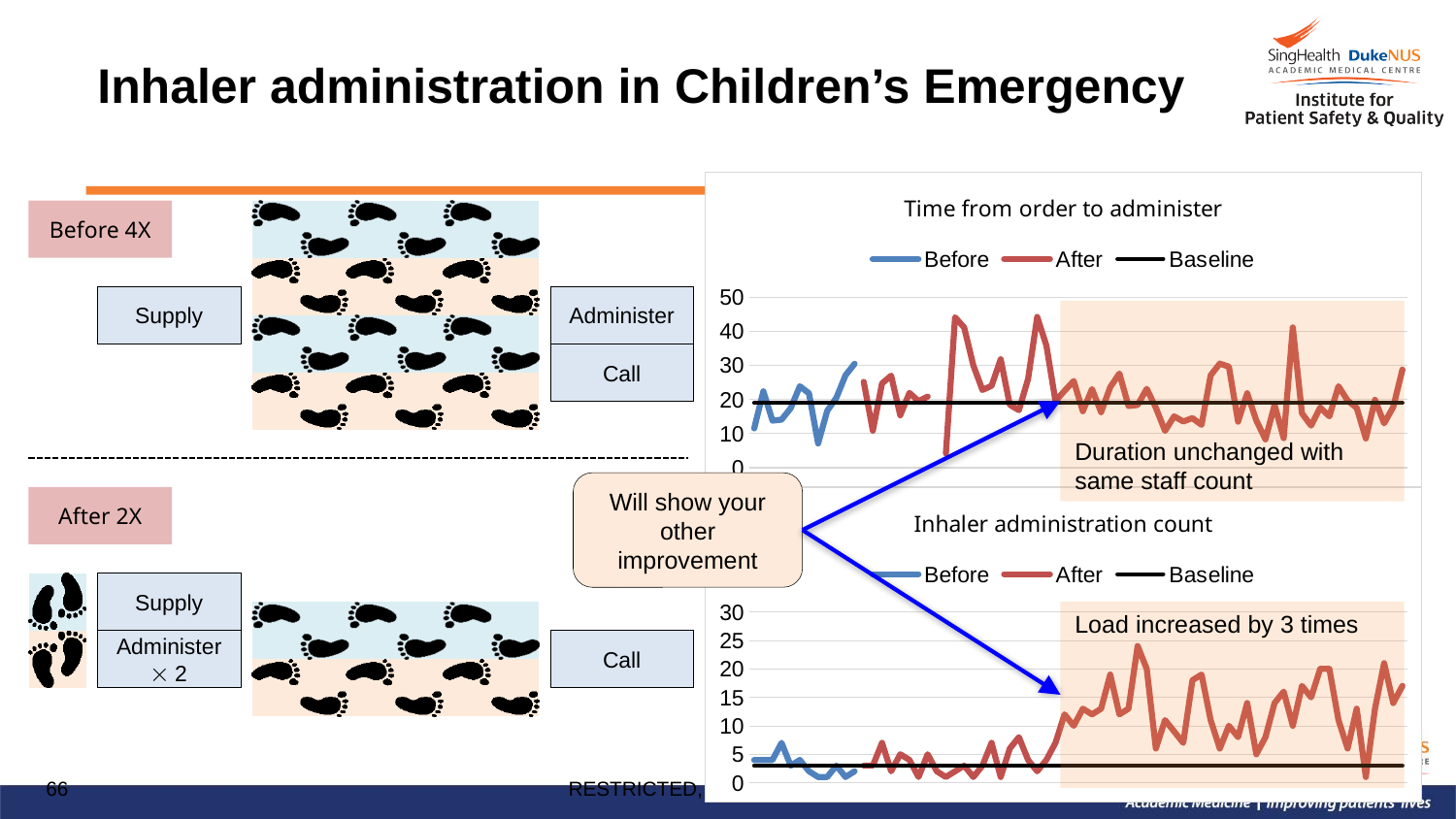
In the "Inhaler administration count" chart, which series has higher values overall, Before or After? After In the "Time from order to administer" chart, is the highest peak of the After series greater or less than 40? greater In the "Inhaler administration count" chart, is the highest peak of the After series greater or less than 20? greater How many series does the legend of the "Inhaler administration count" chart list? 3 What kind of chart is the "Time from order to administer" chart? line chart What kind of chart is the "Inhaler administration count" chart? line chart In the "Inhaler administration count" chart, do the After values generally rise or fall compared with the Before values? rise In the "Inhaler administration count" chart, is the Baseline value greater or less than 5? less What is the title of the upper chart on the slide? Time from order to administer How many series does the legend of the "Time from order to administer" chart list? 3 In the "Inhaler administration count" chart, which series is drawn in red? After